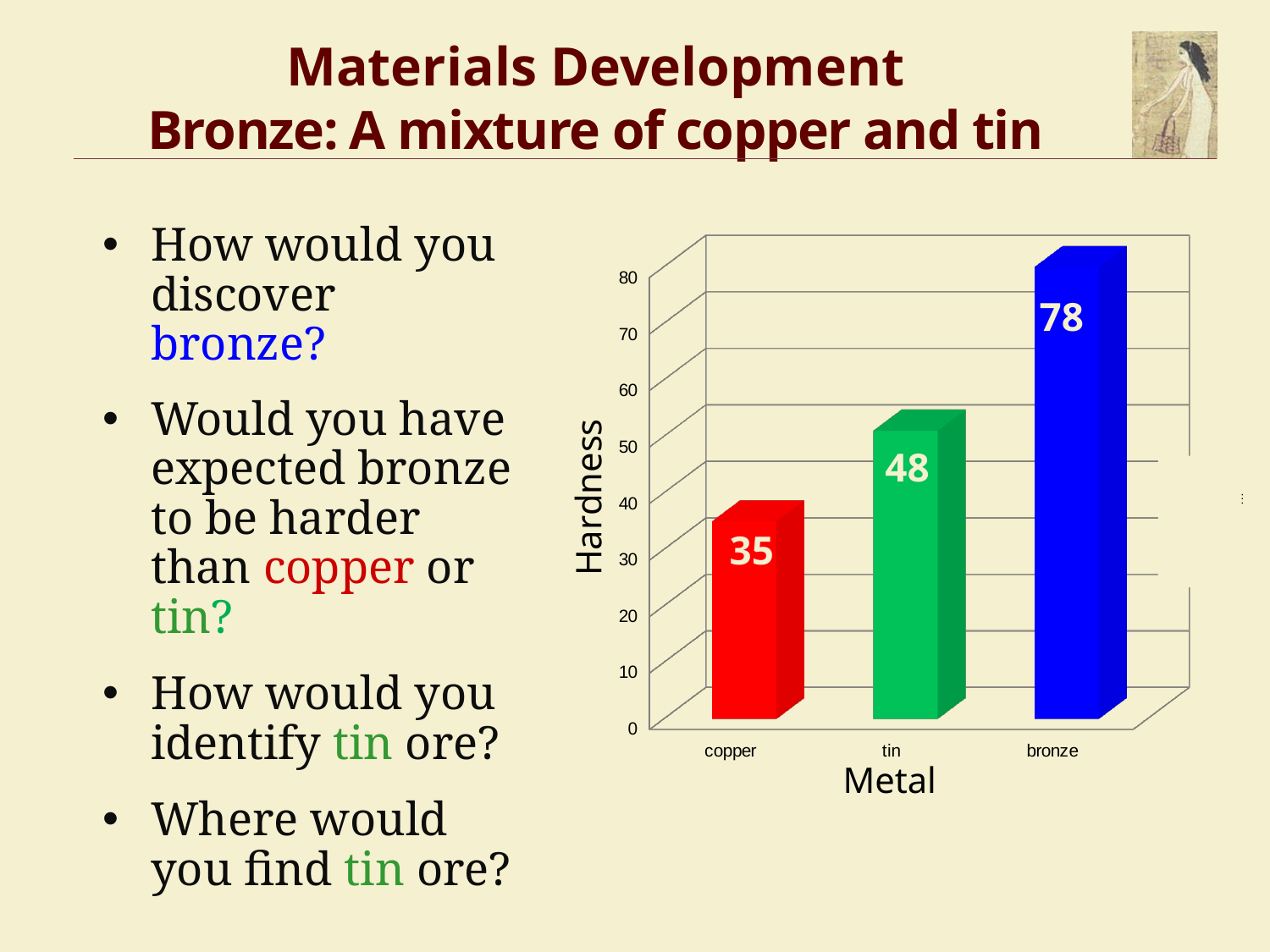
Which has a higher hardness, tin or copper? tin Is the hardness of bronze greater or less than 70? greater Which metal has the highest hardness? bronze What is the label of the vertical axis of the chart? Hardness What is the hardness value for tin? 48 How many metals are shown in the chart? 3 What is the difference in hardness between tin and copper? 13 Which metal has the lowest hardness? copper What is the hardness value for copper? 35 What type of chart is shown on the slide? bar chart What is the hardness value for bronze? 78 What is the difference in hardness between bronze and copper? 43